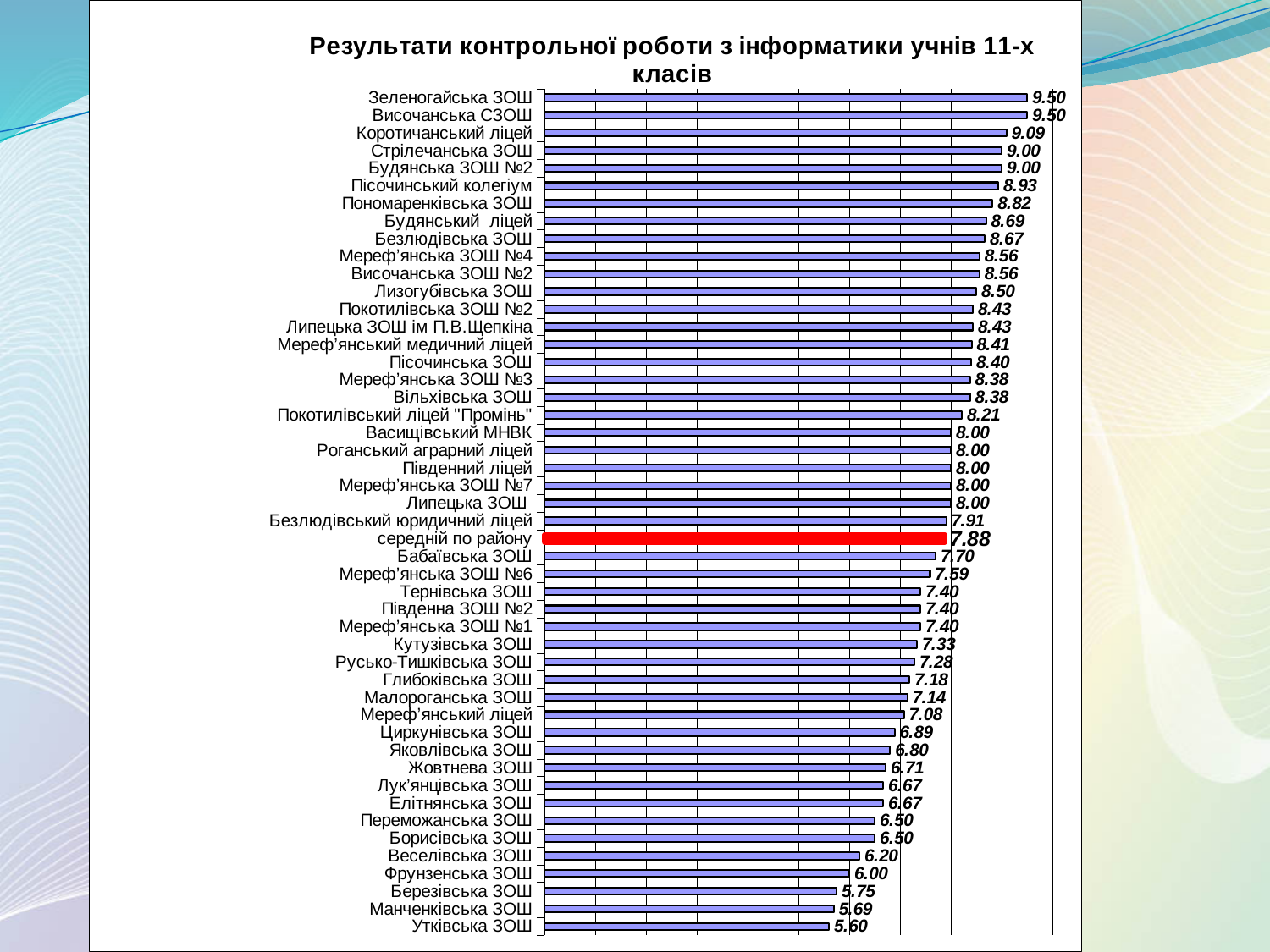
What is the title of the chart? Результати контрольної роботи з інформатики учнів 11-х класів How many categories are plotted in the chart? 48 What is the value for середній по району? 7.88 Which bar is highlighted in red? середній по району What is the difference between the values for Зеленогайська ЗОШ and Утківська ЗОШ? 3.90 What type of chart is shown on the slide? bar chart What is the value for Зеленогайська ЗОШ? 9.50 What is the value for Утківська ЗОШ? 5.60 Which category has the lowest value? Утківська ЗОШ What is the value for Пісочинський колегіум? 8.93 What is the difference between the values for Коротичанський ліцей and Бабаївська ЗОШ? 1.39 Which has a larger value, Кутузівська ЗОШ or Циркунівська ЗОШ? Кутузівська ЗОШ